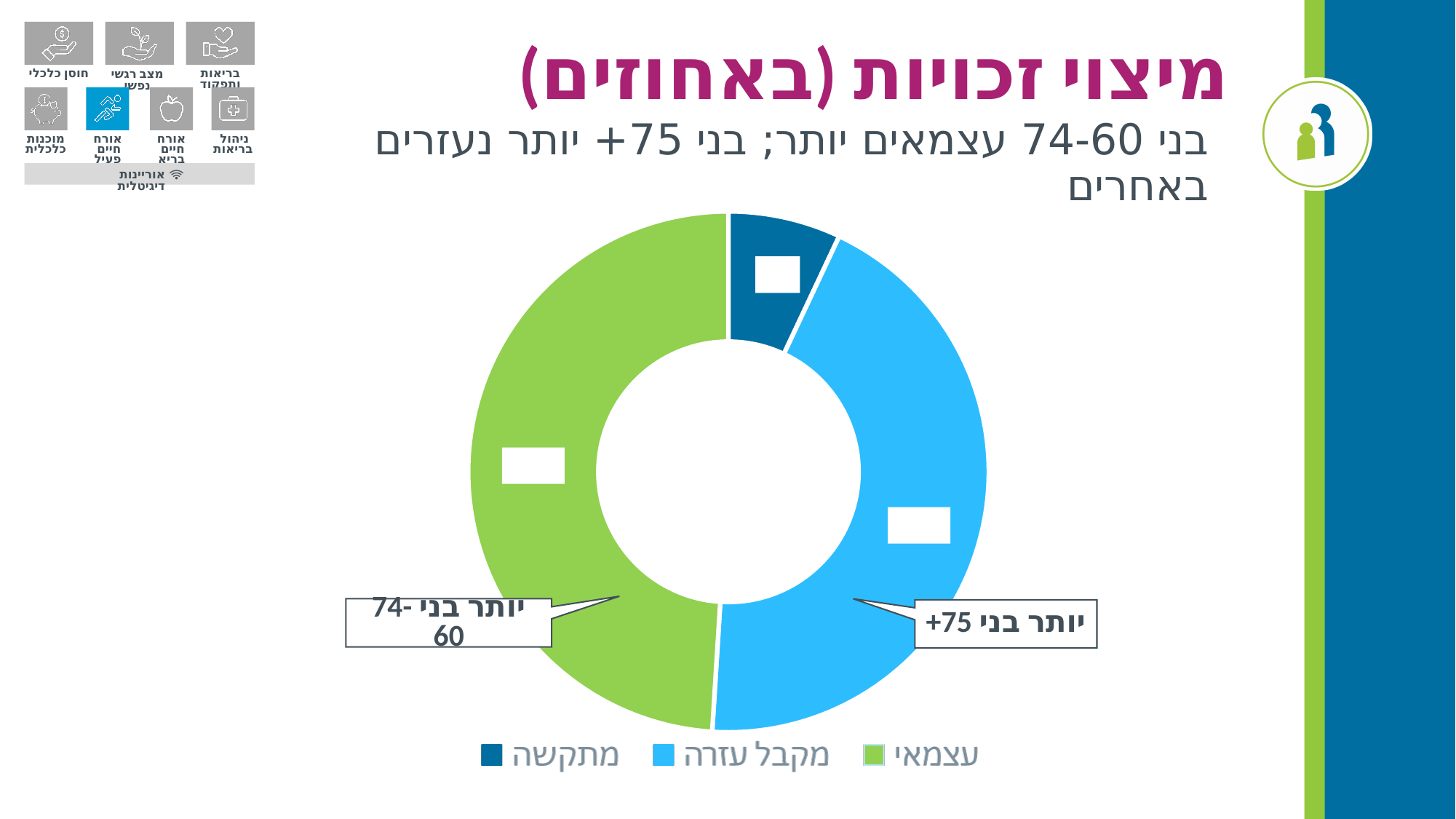
Which is larger in the chart: the share for מקבל עזרה or the share for מתקשה? מקבל עזרה Which colour represents the category עצמאי in the chart? Green What is the title of the chart slide? מיצוי זכויות (באחוזים) What kind of chart is shown on the slide? Doughnut (pie) chart Which is larger in the chart: the share for עצמאי or the share for מקבל עזרה? עצמאי According to the callout on the chart, which age group is more represented in the עצמאי (green) slice? בני 60-74 Which category takes up the largest share of the doughnut chart? עצמאי Which category takes up the smallest share of the doughnut chart? מתקשה According to the callout on the chart, which age group is more represented in the מקבל עזרה (light blue) slice? בני 75+ Which category is represented by the dark blue slice? מתקשה How many categories does the chart's legend list? 3